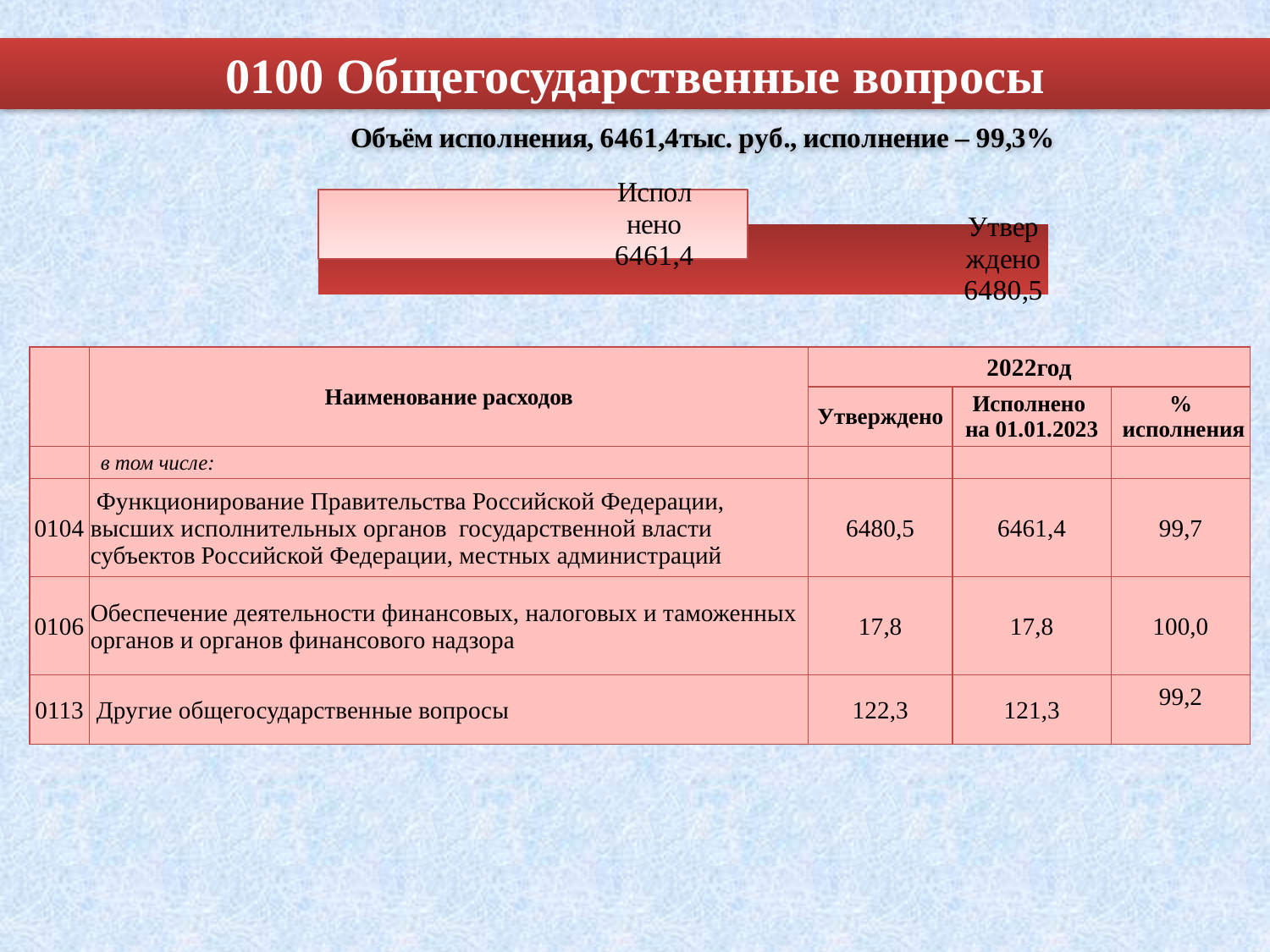
What is the difference between the Утверждено value and the Исполнено value in the chart? 19,1 Which bar has the higher value, Исполнено or Утверждено? Утверждено What type of chart is shown on the slide? bar chart What is the value of the bar labelled Утверждено? 6480,5 What colour is the Утверждено bar in the chart? dark red Which bar in the chart has the lowest value? Исполнено How many bars does the chart show? 2 What colour is the Исполнено bar in the chart? light pink Which bar in the chart has the highest value? Утверждено What is the value of the bar labelled Исполнено? 6461,4